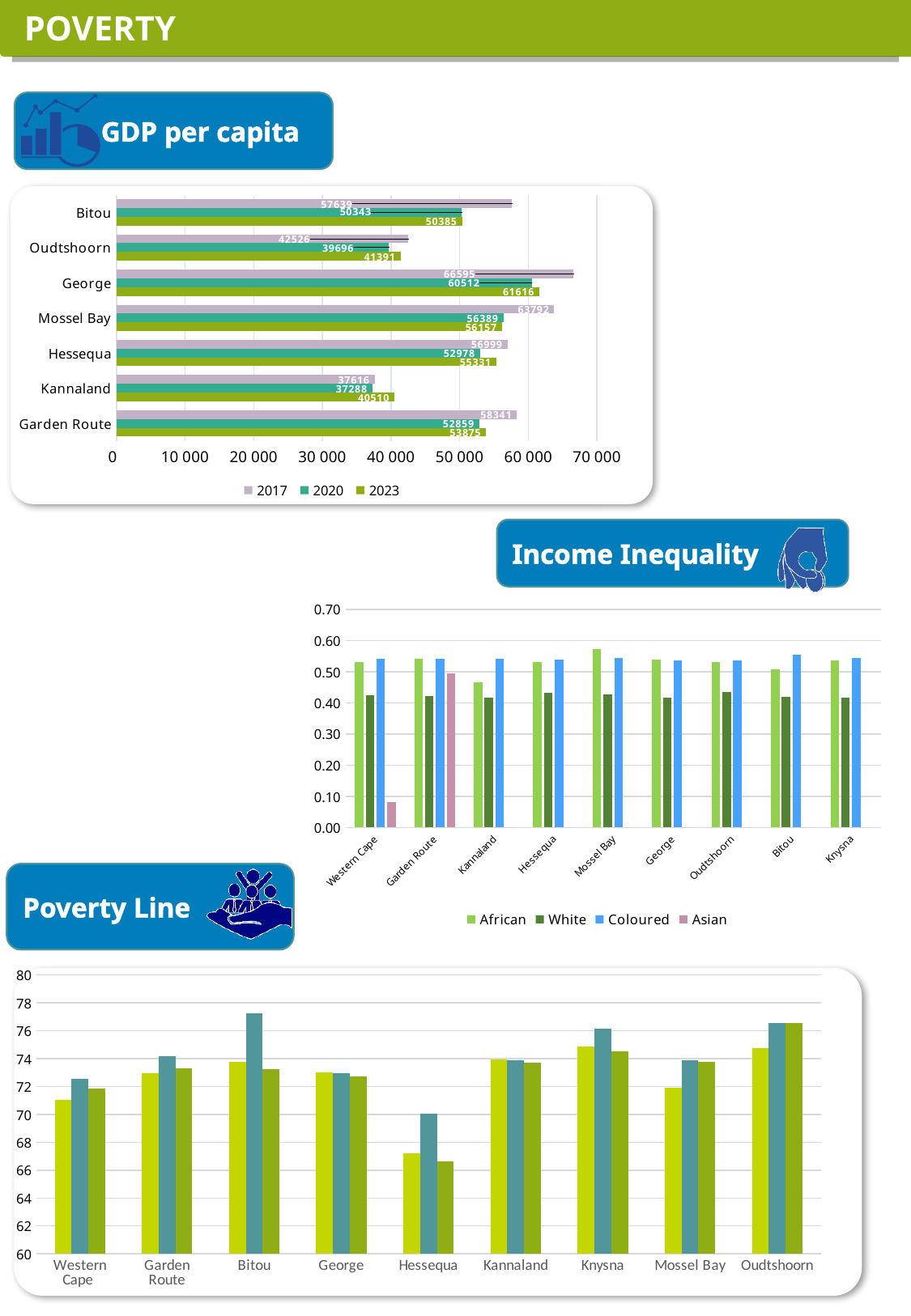
In the Income Inequality chart, is the Asian value for Western Cape greater or less than 0.10? less In the GDP per capita chart, which municipality has the lowest 2023 value? Kannaland In the GDP per capita chart, what is the 2023 value for George? 61616 In the GDP per capita chart, which municipality has the highest 2017 value? George How many municipalities are shown in the GDP per capita chart? 7 In the GDP per capita chart, what is the 2017 value for Kannaland? 37616 How many series does the legend of the Income Inequality chart list? 4 How many categories are shown on the x axis of the Poverty Line chart? 9 In the GDP per capita chart, what is the difference between the 2017 and 2023 values for George? 4979 How many series does the legend of the GDP per capita chart list? 3 What kind of chart is the GDP per capita chart? bar chart In the GDP per capita chart, which is larger for Hessequa: the 2020 value or the 2023 value? 2023